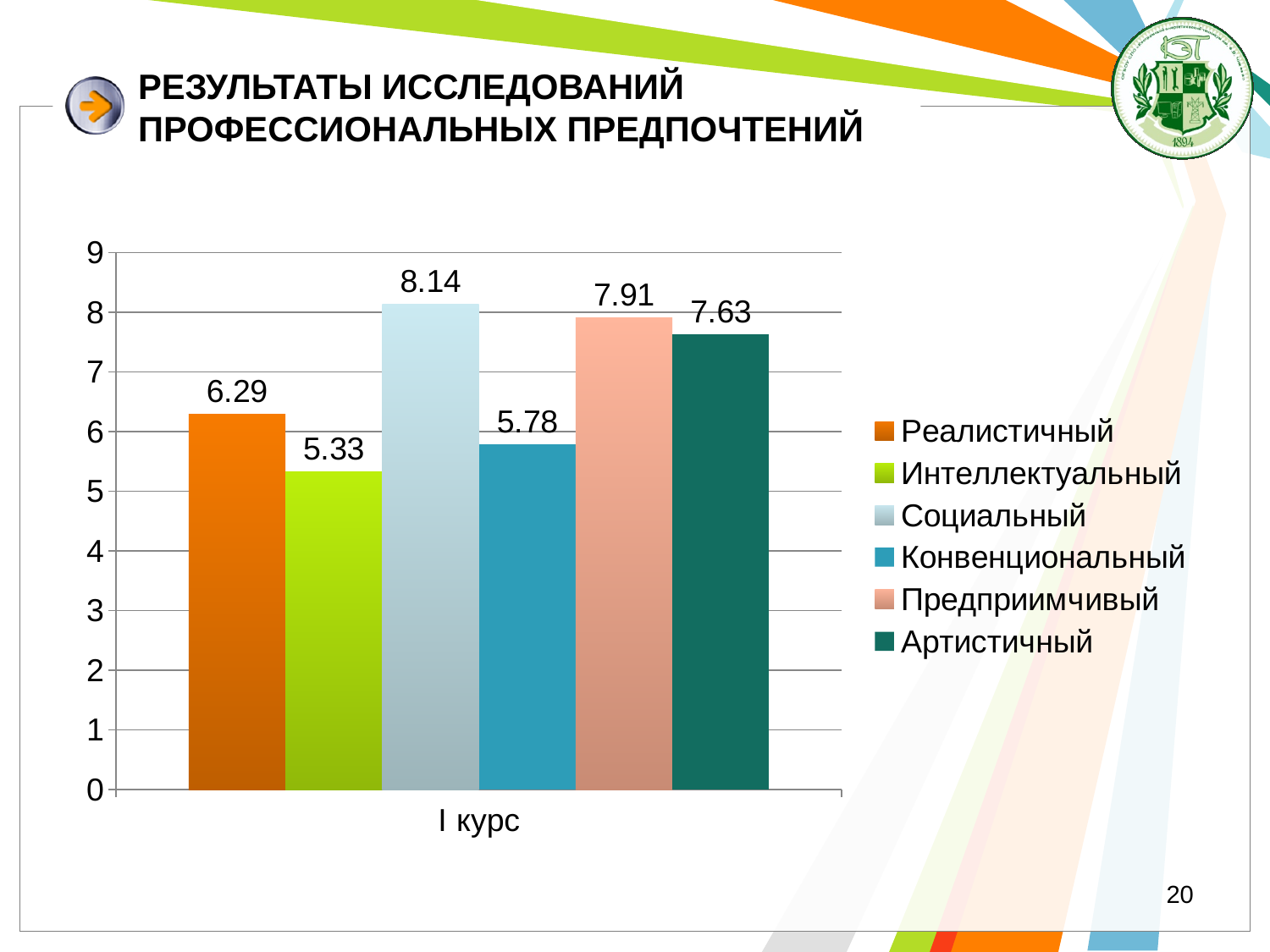
Which series has the lowest value? Интеллектуальный What is the value for Реалистичный? 6.29 What is the category label shown on the x axis? I курс What colour is the bar for Реалистичный? orange What kind of chart is shown on the slide? bar chart How many series does the legend list? 6 Which is larger, the value for Предприимчивый or the value for Артистичный? Предприимчивый What is the value for Конвенциональный? 5.78 What is the value for Социальный? 8.14 Is the value for Артистичный greater or less than 7? greater What is the difference between the values for Социальный and Интеллектуальный? 2.81 Which series has the highest value? Социальный